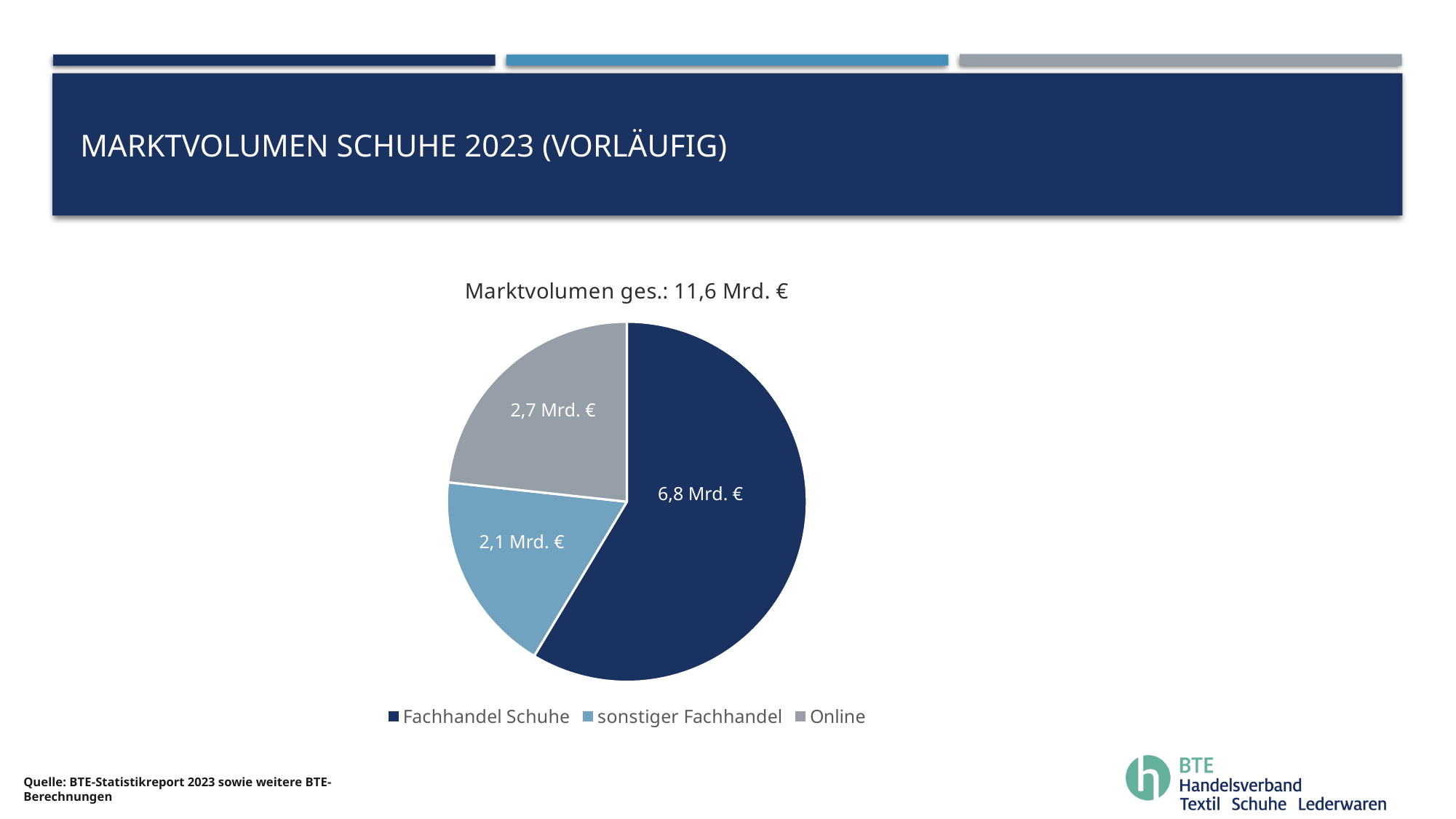
What kind of chart is shown on the slide? pie chart Which category has the largest slice of the pie? Fachhandel Schuhe What is the chart's title? Marktvolumen ges.: 11,6 Mrd. € What is the value for sonstiger Fachhandel? 2,1 Mrd. € What is the value for Fachhandel Schuhe? 6,8 Mrd. € What is the difference between the values for Online and sonstiger Fachhandel? 0,6 Mrd. € What is the difference between the values for Fachhandel Schuhe and Online? 4,1 Mrd. € How many slices does the pie chart have? 3 Which is larger, the value for Online or the value for sonstiger Fachhandel? Online What is the total of all slices in the pie chart? 11,6 Mrd. € Which category has the smallest slice of the pie? sonstiger Fachhandel What is the value for Online? 2,7 Mrd. €